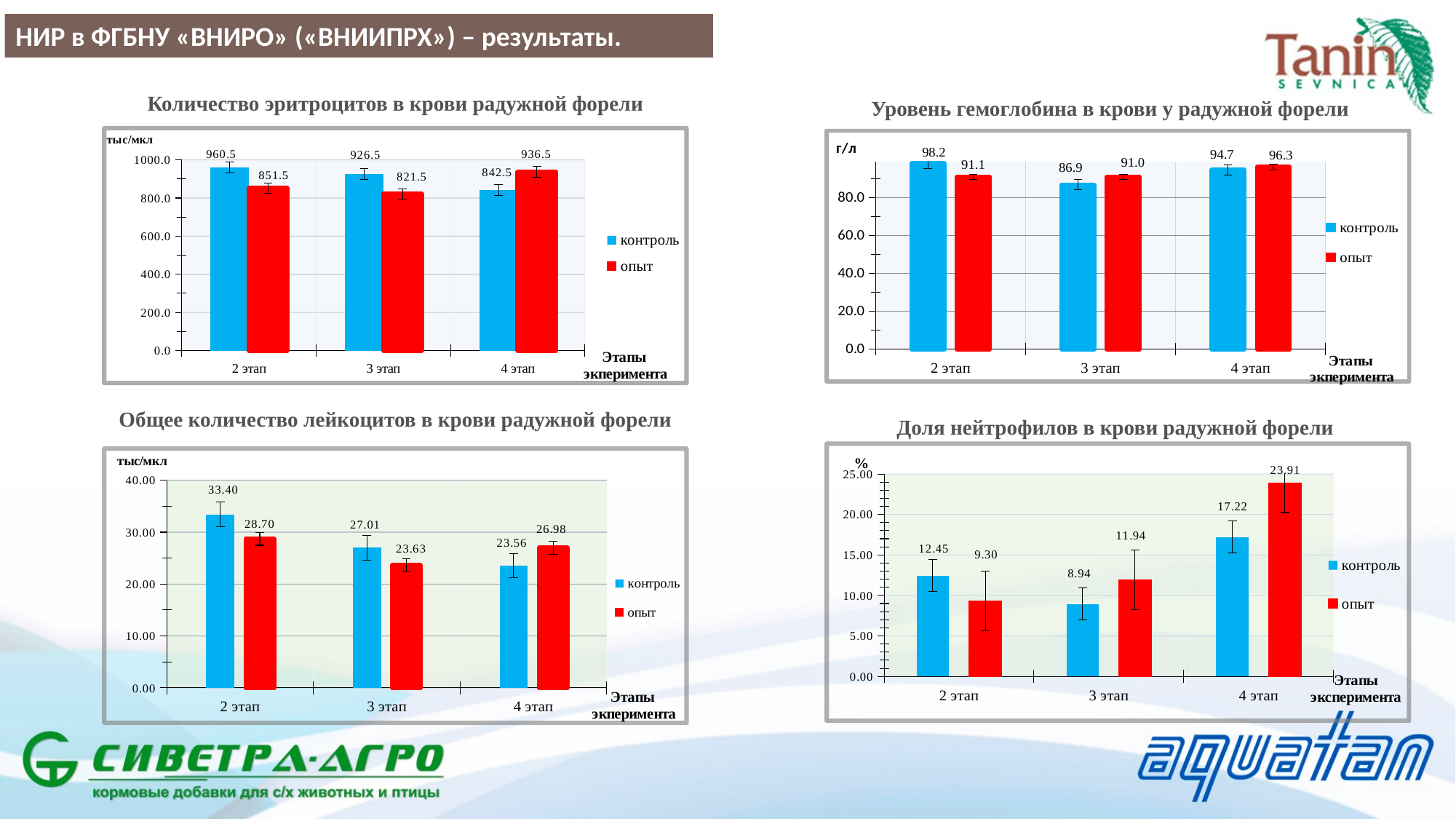
In the chart titled «Уровень гемоглобина в крови у радужной форели», which is larger at 3 этап, контроль or опыт? опыт In the chart titled «Доля нейтрофилов в крови радужной форели», how many series does the legend list? 2 In the chart titled «Доля нейтрофилов в крови радужной форели», what is the value for опыт at 4 этап? 23.91 In the chart titled «Уровень гемоглобина в крови у радужной форели», which stage has the highest контроль value? 2 этап In the chart titled «Уровень гемоглобина в крови у радужной форели», what is the value for опыт at 3 этап? 91.0 In the chart titled «Количество эритроцитов в крови радужной форели», what is the difference between контроль and опыт at 4 этап? 94.0 In the chart titled «Общее количество лейкоцитов в крови радужной форели», does the контроль series rise or fall from 2 этап to 4 этап? fall In the chart titled «Доля нейтрофилов в крови радужной форели», what is the difference between опыт and контроль at 4 этап? 6.69 In the chart titled «Общее количество лейкоцитов в крови радужной форели», which stage has the lowest контроль value? 4 этап In the chart titled «Общее количество лейкоцитов в крови радужной форели», what is the value for опыт at 2 этап? 28.70 In the chart titled «Количество эритроцитов в крови радужной форели», what is the value for контроль at 2 этап? 960.5 What kind of chart is the one titled «Количество эритроцитов в крови радужной форели»? bar chart